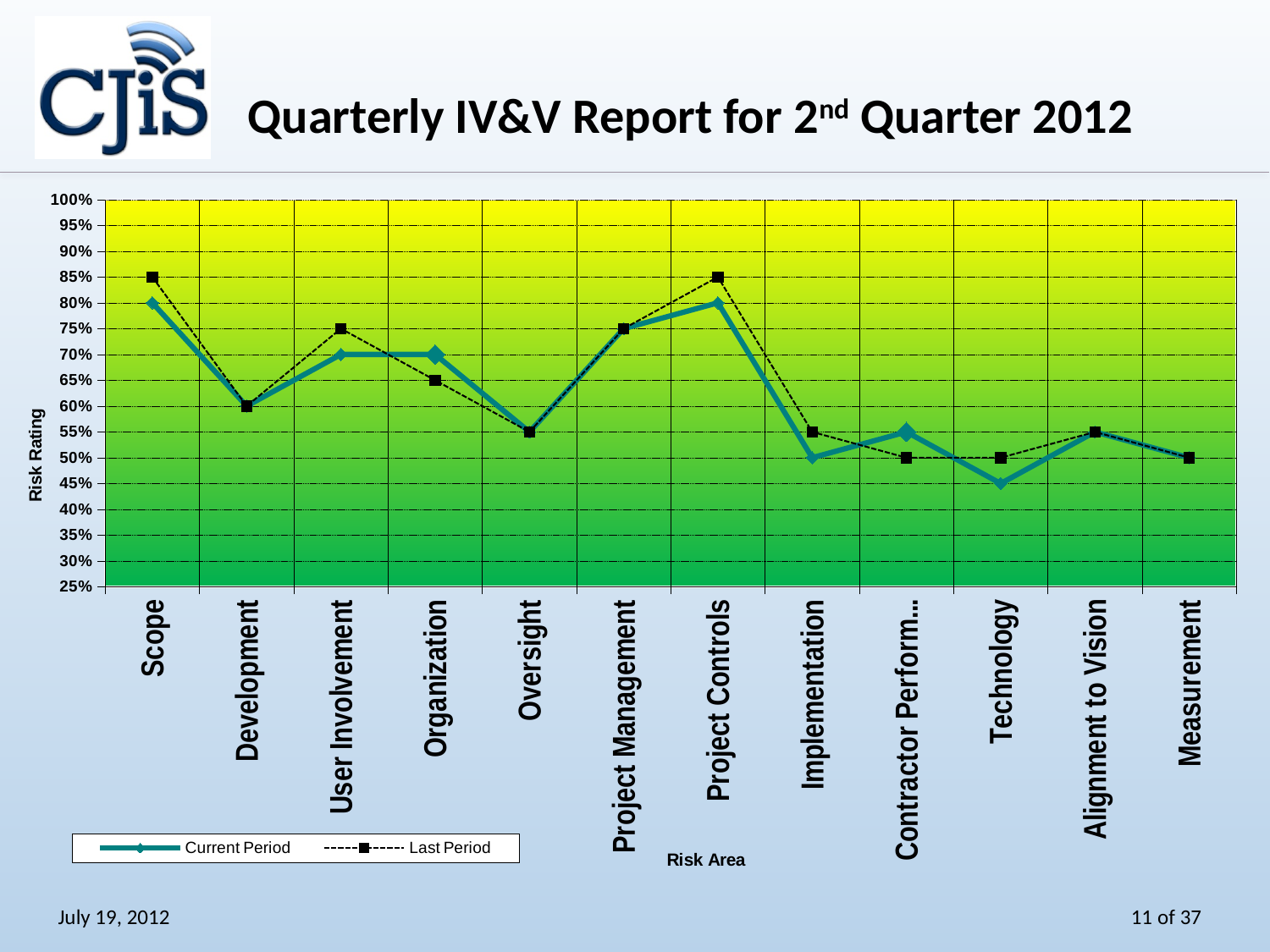
What is the Current Period risk rating for Project Controls? 80% What is the Current Period risk rating for Technology? 45% Which risk area has the lowest Current Period rating? Technology What is the label on the y axis? Risk Rating How many risk areas are plotted along the x axis? 12 For Organization, which series has the higher value, Current Period or Last Period? Current Period What kind of chart is shown on the slide? line chart What is the difference between the Last Period and Current Period ratings for Scope? 5% Is the Current Period value for Implementation greater or less than 70%? less For Scope, which series has the higher value, Current Period or Last Period? Last Period How many series does the legend list? 2 What is the Last Period risk rating for Scope? 85%